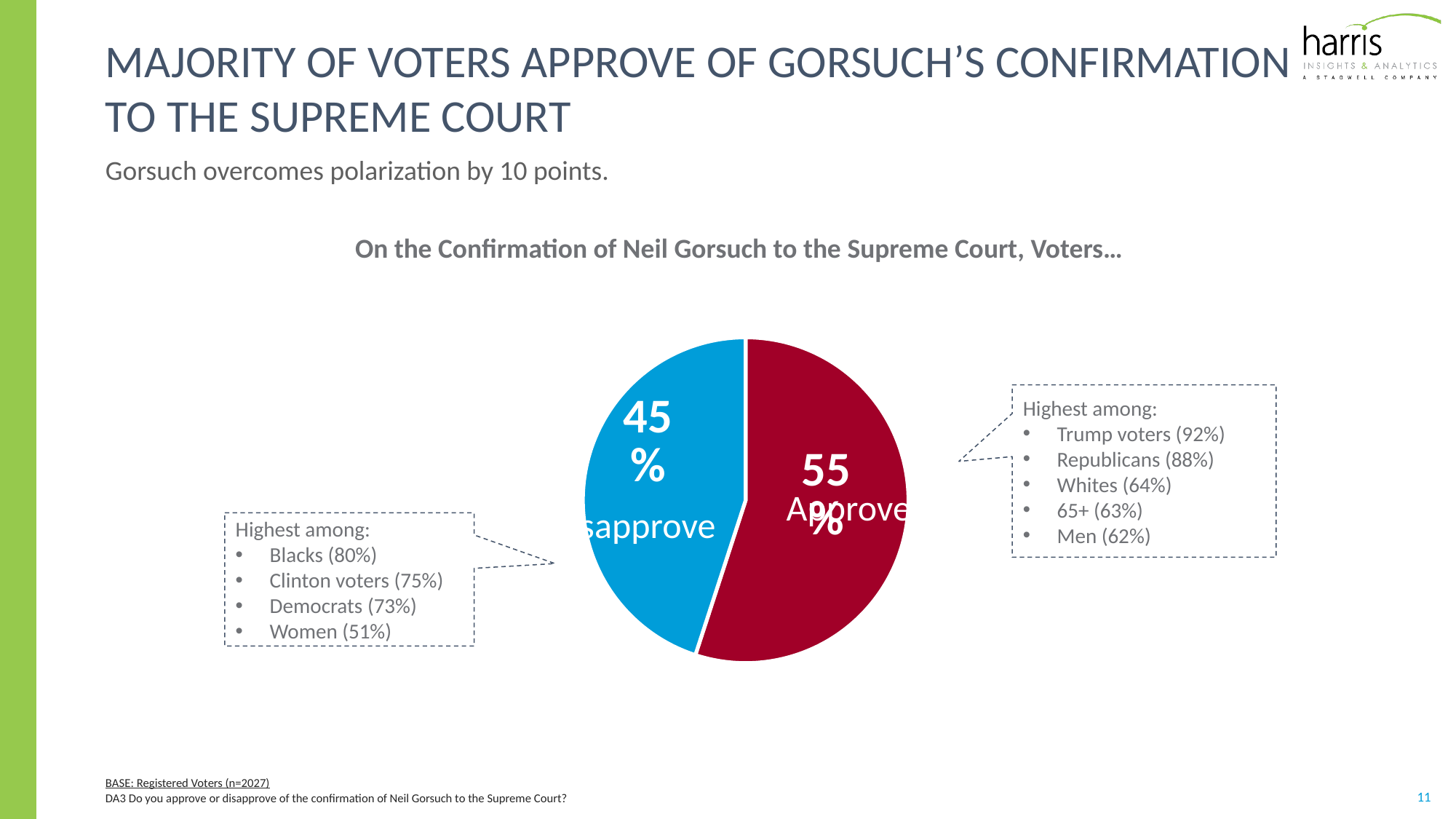
Which response has the largest share in the pie chart? Approve What is the combined total of the Approve and Disapprove slices? 100% Which slice of the pie chart is larger, Approve or Disapprove? Approve What type of chart is shown on the slide? Pie chart What is the difference in percentage points between the Approve and Disapprove slices? 10 What percentage of voters disapprove of Gorsuch's confirmation according to the pie chart? 45% Is the Approve share in the pie chart greater or less than 50%? greater What colour is the Approve slice of the pie chart? Red How many slices does the pie chart have? 2 What percentage of voters approve of Gorsuch's confirmation according to the pie chart? 55% Which response has the smallest share in the pie chart? Disapprove What is the title of the chart on the slide? On the Confirmation of Neil Gorsuch to the Supreme Court, Voters…